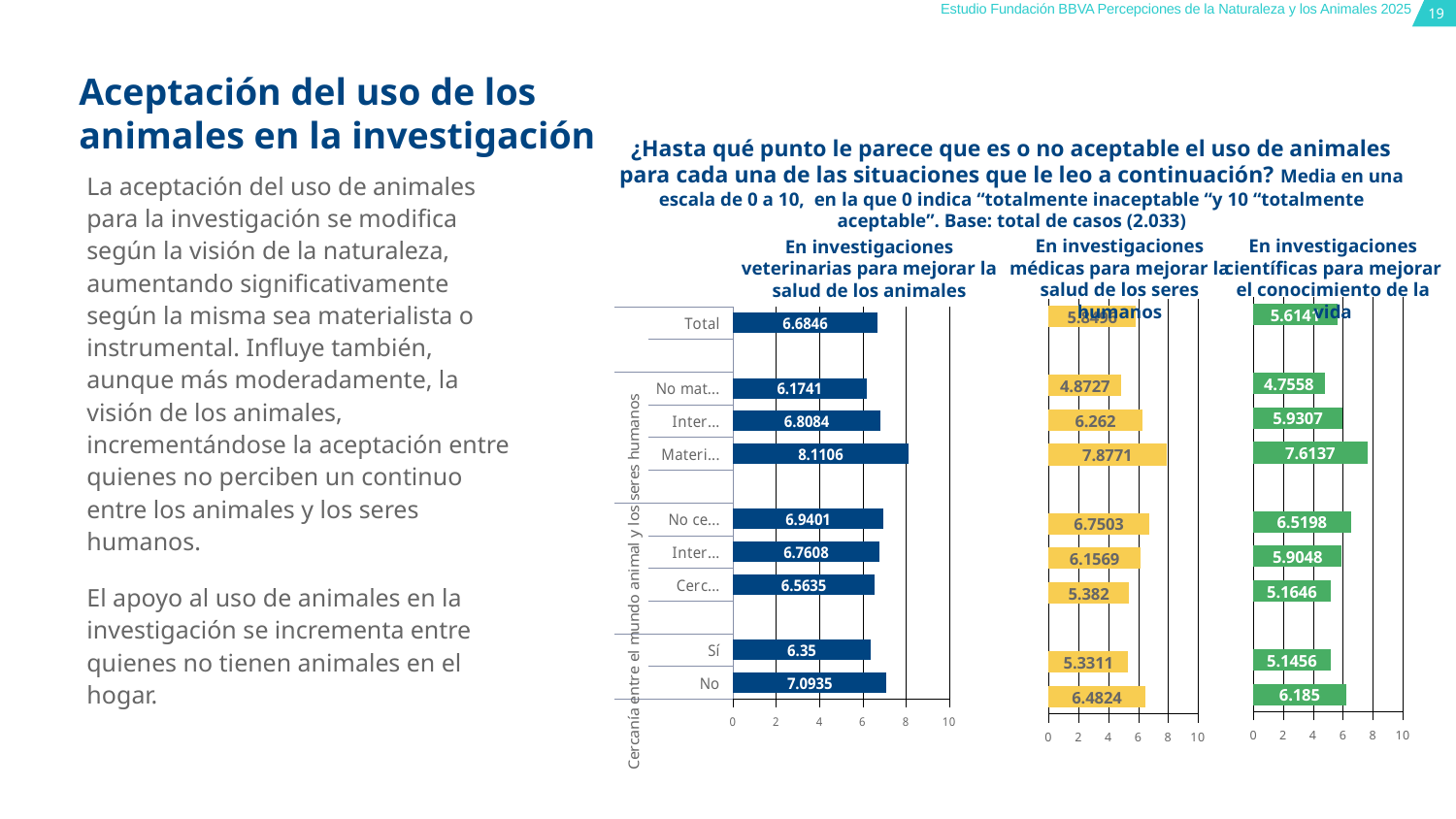
In the middle chart 'En investigaciones médicas para mejorar la salud de los seres humanos', what is the value for 'No mat...'? 4.8727 In the chart 'En investigaciones veterinarias para mejorar la salud de los animales', which category has the lowest value? No mat... How many bars are plotted in the chart 'En investigaciones veterinarias para mejorar la salud de los animales'? 9 In the middle chart 'En investigaciones médicas para mejorar la salud de los seres humanos', which is larger, the value for 'No ce...' or for 'Cerc...'? No ce... In the chart 'En investigaciones veterinarias para mejorar la salud de los animales', what is the value for the 'Materi...' category? 8.1106 What kind of chart is used on this slide? Bar chart In the chart 'En investigaciones veterinarias para mejorar la salud de los animales', what is the value for Total? 6.6846 In the middle chart 'En investigaciones médicas para mejorar la salud de los seres humanos', which category has the highest value? Materi... In the right chart 'En investigaciones científicas para mejorar el conocimiento de la vida', what is the value for 'Materi...'? 7.6137 In the right chart 'En investigaciones científicas para mejorar el conocimiento de la vida', which category has the lowest value? No mat... In the chart 'En investigaciones veterinarias para mejorar la salud de los animales', which category has the highest value? Materi... In the chart 'En investigaciones veterinarias para mejorar la salud de los animales', what is the difference between the values for 'No' and 'Sí'? 0.7435